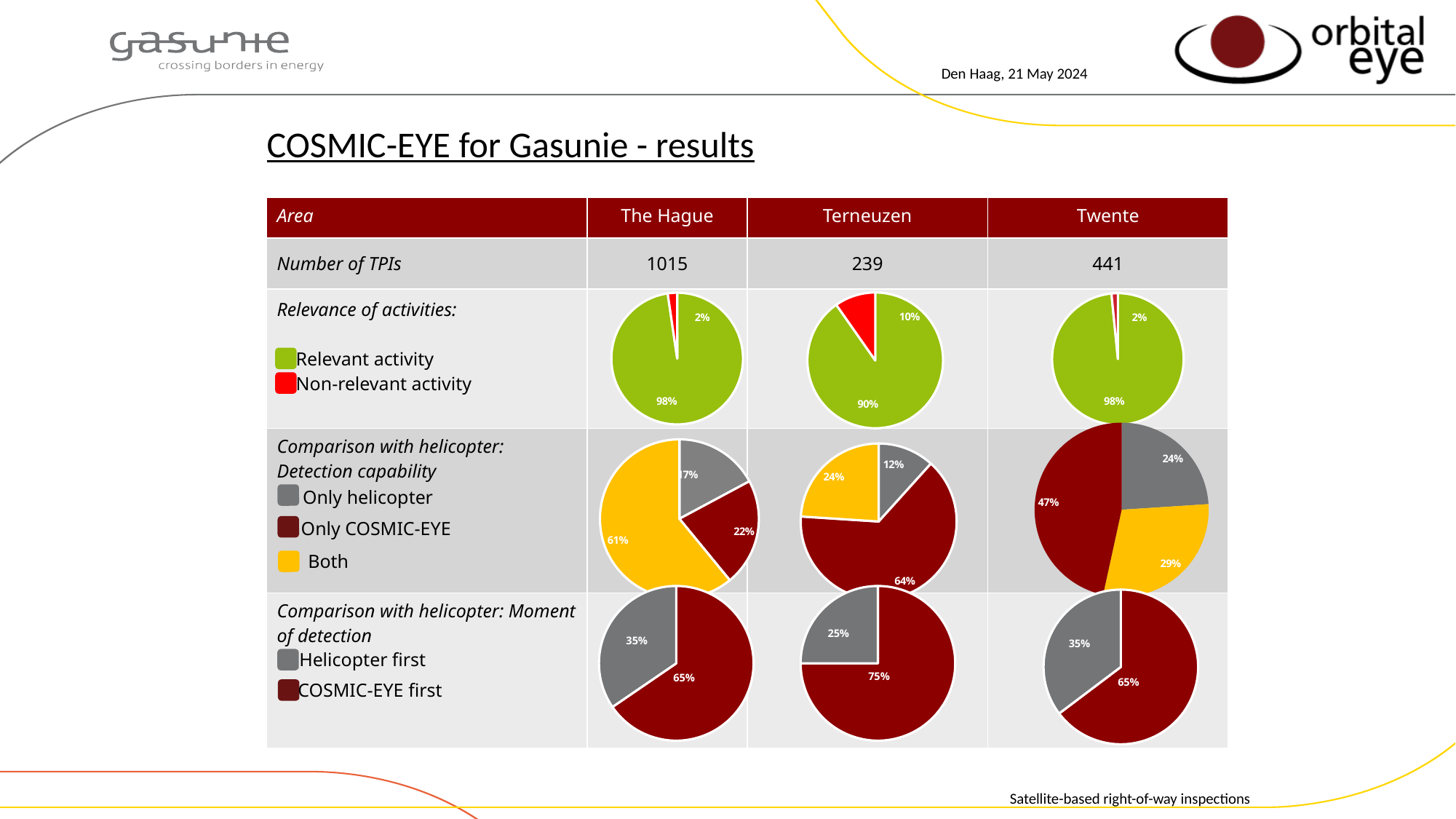
In the 'Relevance of activities' pie chart for Terneuzen, what share is non-relevant activity? 10% In the 'Detection capability' pie chart for Twente, which is larger: 'Both' or 'Only helicopter'? Both How many slices does the 'Detection capability' pie chart for The Hague have? 3 In the 'Relevance of activities' pie chart for The Hague, what share is relevant activity? 98% In the 'Detection capability' pie chart for Terneuzen, what share is 'Only COSMIC-EYE'? 64% In the 'Detection capability' pie chart for Twente, which category has the largest slice? Only COSMIC-EYE In the 'Detection capability' pie chart for The Hague, what share is 'Both'? 61% In the 'Moment of detection' pie chart for Twente, what is the difference between the 'COSMIC-EYE first' and 'Helicopter first' shares? 30% In the 'Detection capability' pie chart for Terneuzen, which category has the smallest slice? Only helicopter How many categories does the legend for 'Comparison with helicopter: Moment of detection' list? 2 In the 'Moment of detection' pie chart for Terneuzen, what share is 'COSMIC-EYE first'? 75% What type of chart is used in the 'Relevance of activities' row? Pie chart